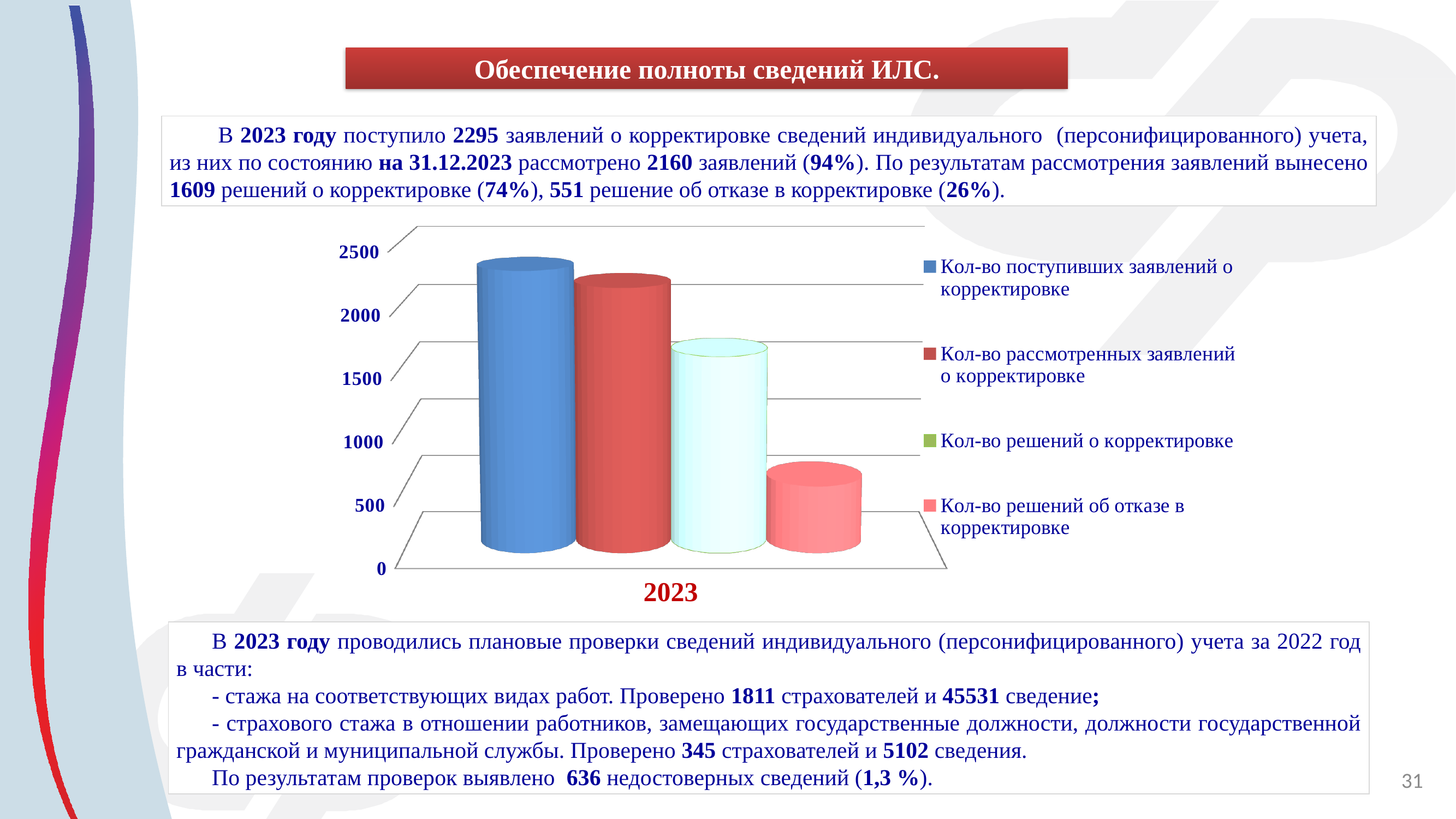
Which series has the shortest bar in the chart? Кол-во решений об отказе в корректировке Which is larger: "Кол-во рассмотренных заявлений о корректировке" or "Кол-во решений о корректировке"? Кол-во рассмотренных заявлений о корректировке What colour is the bar for "Кол-во рассмотренных заявлений о корректировке"? red Is the value for "Кол-во поступивших заявлений о корректировке" greater or less than 2000? greater Is the value for "Кол-во решений о корректировке" greater or less than 2000? less Which series has the tallest bar in the chart? Кол-во поступивших заявлений о корректировке Is the value for "Кол-во решений об отказе в корректировке" greater or less than 1000? less Which category label appears on the x axis of the chart? 2023 How many categories are shown on the x axis of the chart? 1 What kind of chart is shown on the slide? bar chart How many series does the chart legend list? 4 Which is larger: "Кол-во решений о корректировке" or "Кол-во решений об отказе в корректировке"? Кол-во решений о корректировке